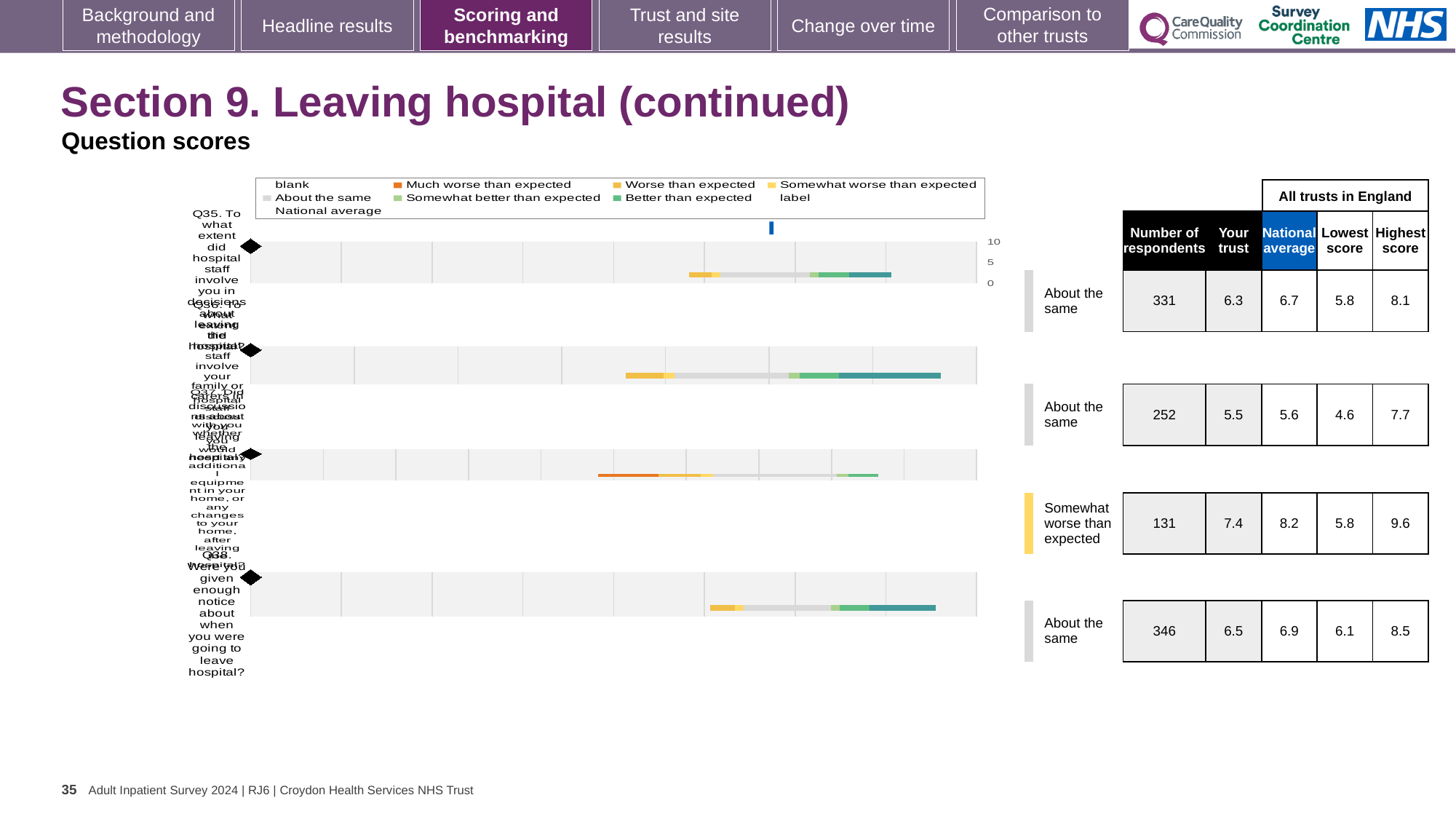
Which question has the lowest 'Your trust' score? Q36 What benchmark category is shown for Q37? Somewhat worse than expected For Q35, which is larger: the 'Your trust' score or the national average? National average How many questions (bars) are plotted in the chart? 4 In the table beside the chart, what is the national average for Q37? 8.2 Which question has the highest 'Your trust' score? Q37 What benchmark category is shown for Q35? About the same What kind of chart is shown on the slide? bar chart In the table beside the chart, how many respondents are listed for Q36? 252 In the table beside the chart, what is the highest score in England for Q38? 8.5 For Q37, what is the difference between the national average and the 'Your trust' score? 0.8 In the table beside the chart, what is the 'Your trust' score for Q35? 6.3